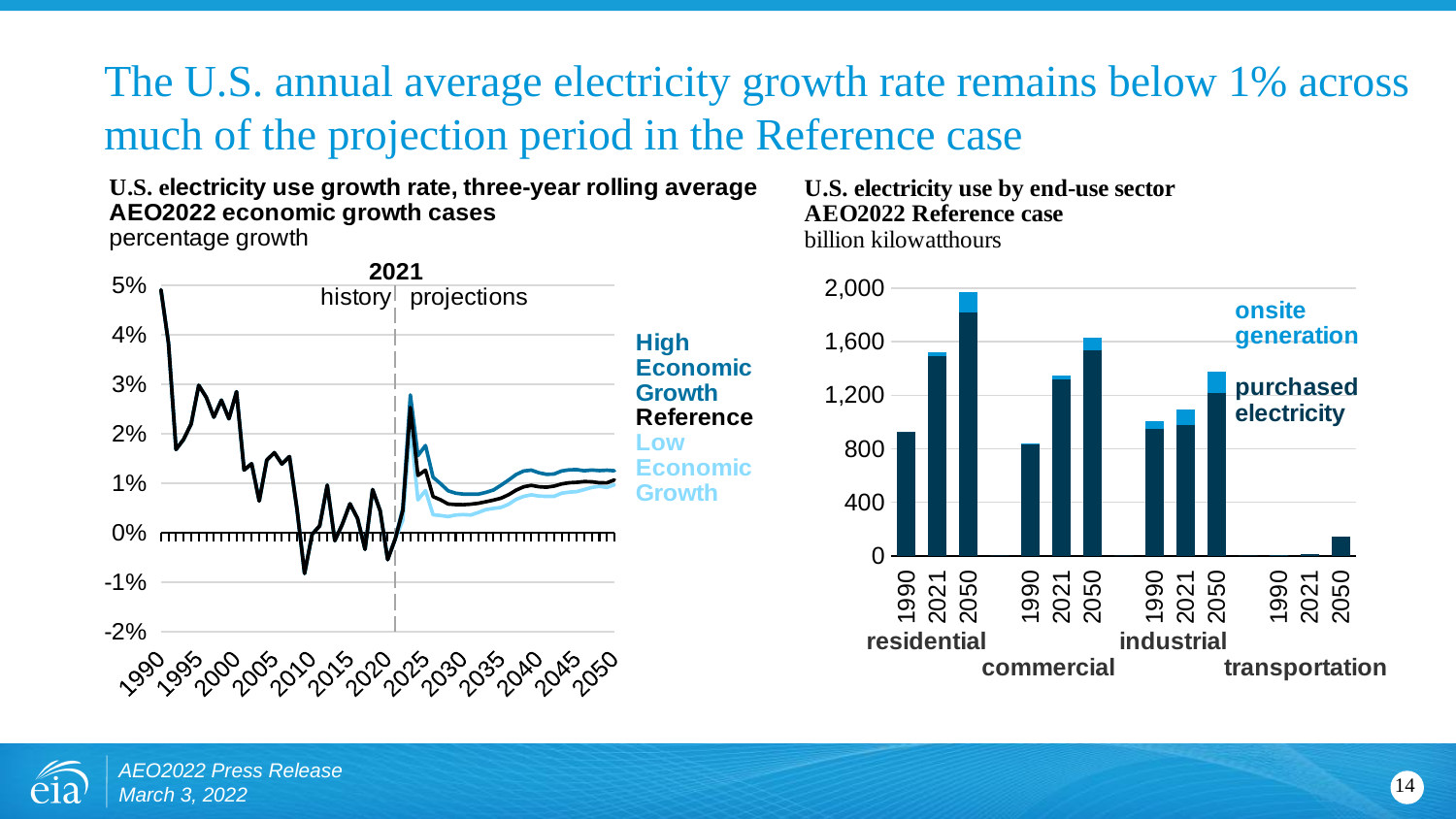
What kind of chart is the chart titled "U.S. electricity use by end-use sector"? bar chart What kind of chart is the chart titled "U.S. electricity use growth rate, three-year rolling average"? line chart In the chart titled "U.S. electricity use by end-use sector", what is the unit of the y axis? billion kilowatthours In the chart titled "U.S. electricity use by end-use sector", how many end-use sectors are shown on the x axis? 4 In the chart titled "U.S. electricity use growth rate, three-year rolling average", how many series are shown? 3 In the chart titled "U.S. electricity use by end-use sector", how many series does the legend list? 2 In the chart titled "U.S. electricity use by end-use sector", which sector has the lowest electricity use? transportation In the chart titled "U.S. electricity use by end-use sector", is the total for transportation in 2050 greater or less than 400? less In the chart titled "U.S. electricity use growth rate, three-year rolling average", is the value in 1990 greater or less than 4%? greater In the chart titled "U.S. electricity use by end-use sector", which sector has the tallest bar? residential In the chart titled "U.S. electricity use by end-use sector", is the total for residential in 2050 greater or less than 1,600? greater In the chart titled "U.S. electricity use by end-use sector", which is larger in 2050: residential or commercial? residential